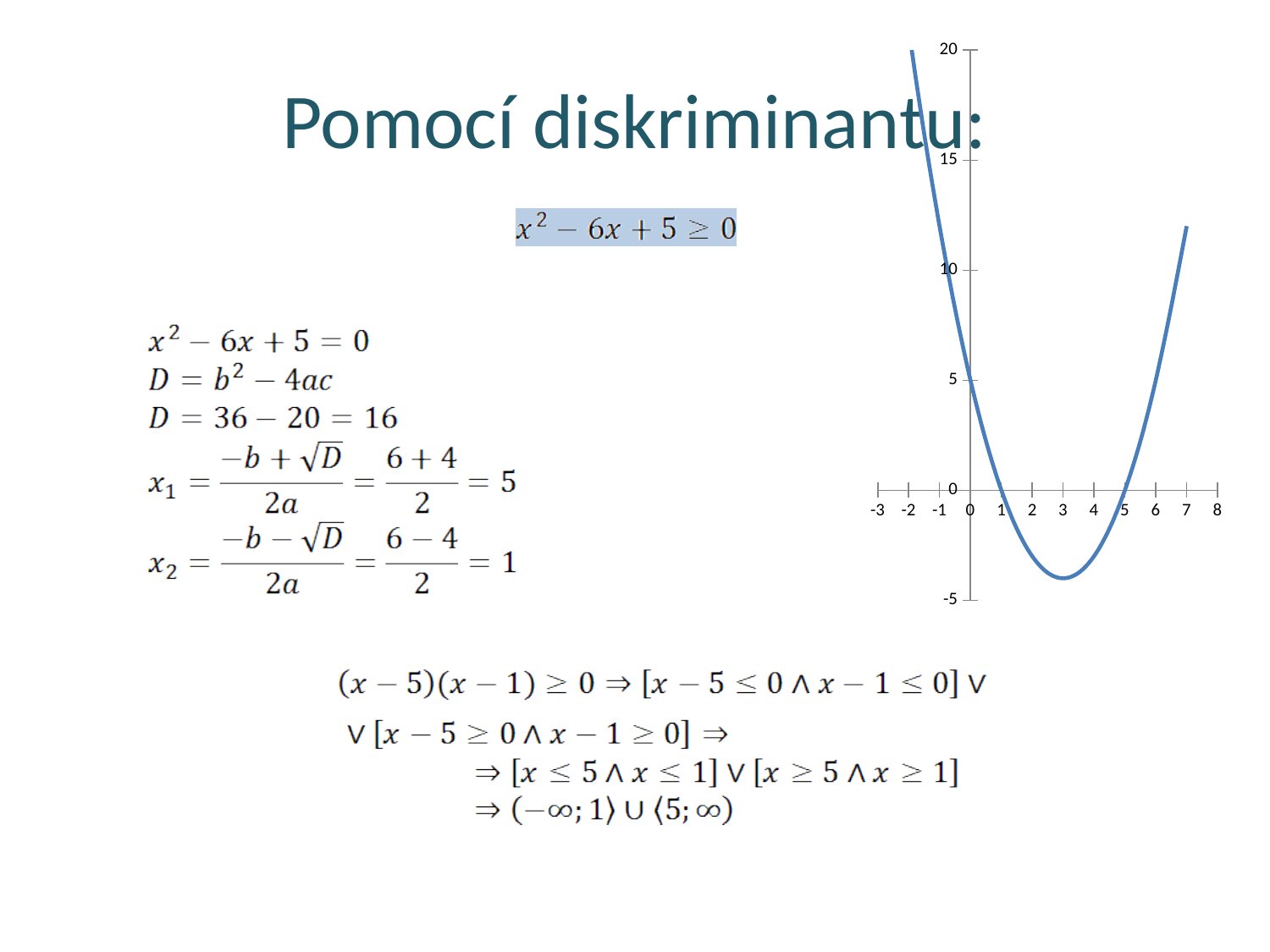
Is the value of the curve at x = 3 greater or less than 0? less How many lines (series) are plotted on the chart? 1 What is the value of the curve at x = 1? 0 At which x value does the plotted curve reach its lowest point? 3 Is the value of the curve at x = 6 greater or less than 0? greater What kind of chart is shown on the slide? line chart What is the value of the curve at x = 0? 5 What is the value of the curve at x = 5? 0 Does the curve rise or fall as x goes from 3 to 7? rises What is the highest value labelled on the vertical axis? 20 Is the value of the curve at x = 7 greater or less than 10? greater Which is larger: the value of the curve at x = 0 or at x = 3? x = 0